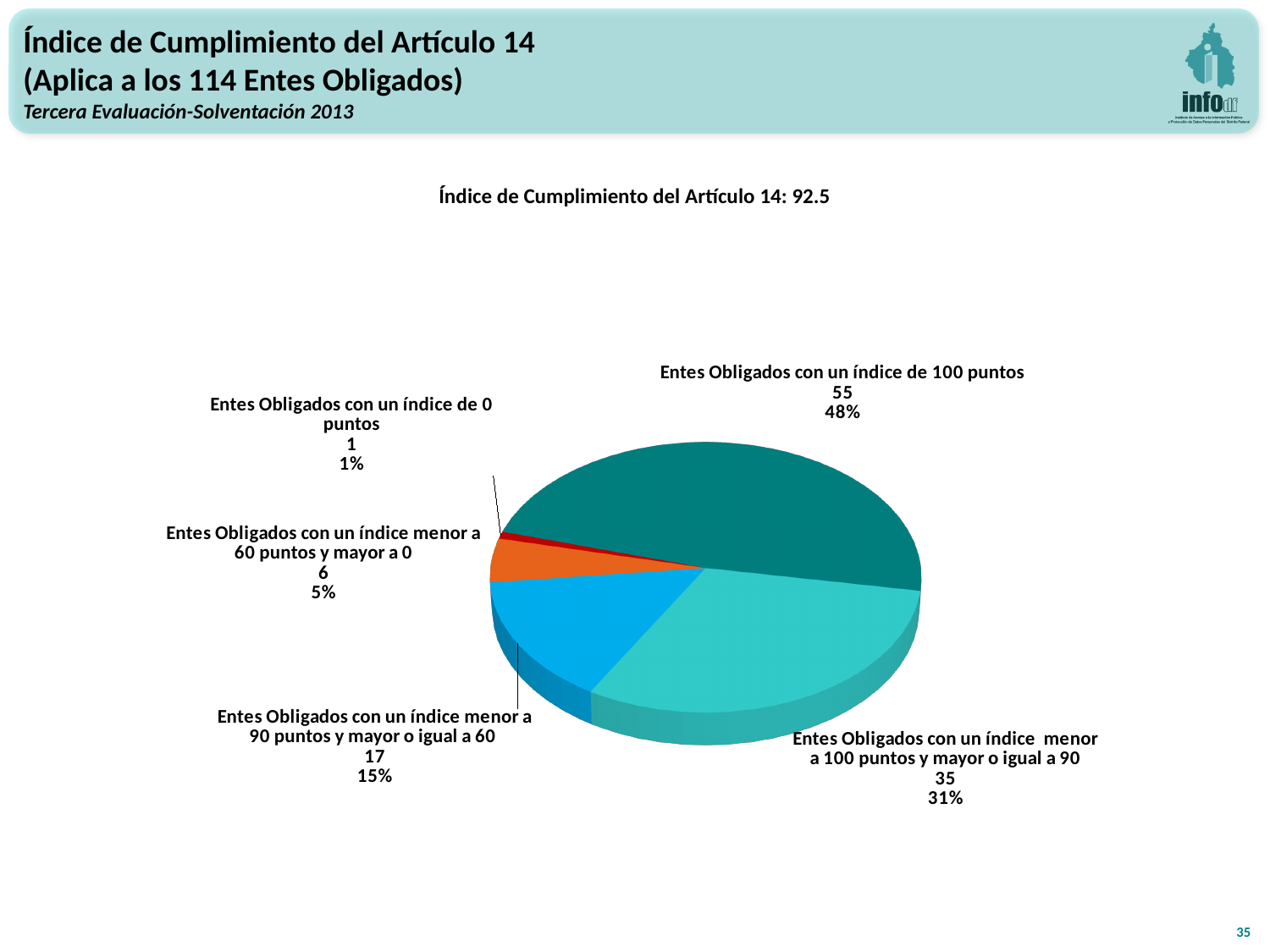
How many Entes Obligados have an índice menor a 90 puntos y mayor o igual a 60? 17 What kind of chart is shown on the slide? pie chart Which is larger: the number of Entes Obligados with an índice menor a 90 puntos y mayor o igual a 60, or those with an índice menor a 60 puntos y mayor a 0? Entes Obligados con un índice menor a 90 puntos y mayor o igual a 60 What colour is the slice for Entes Obligados con un índice de 100 puntos? dark teal What percentage of the pie is for Entes Obligados con un índice menor a 60 puntos y mayor a 0? 5% How many slices does the pie chart have? 5 What is the difference between the number of Entes Obligados with an índice de 100 puntos and those with an índice menor a 100 puntos y mayor o igual a 90? 20 Which category has the largest slice of the pie? Entes Obligados con un índice de 100 puntos What share of the pie corresponds to Entes Obligados con un índice menor a 100 puntos y mayor o igual a 90? 31% Which category has the smallest slice of the pie? Entes Obligados con un índice de 0 puntos What is the Índice de Cumplimiento del Artículo 14 stated in the chart title? 92.5 How many Entes Obligados have an índice de 100 puntos? 55